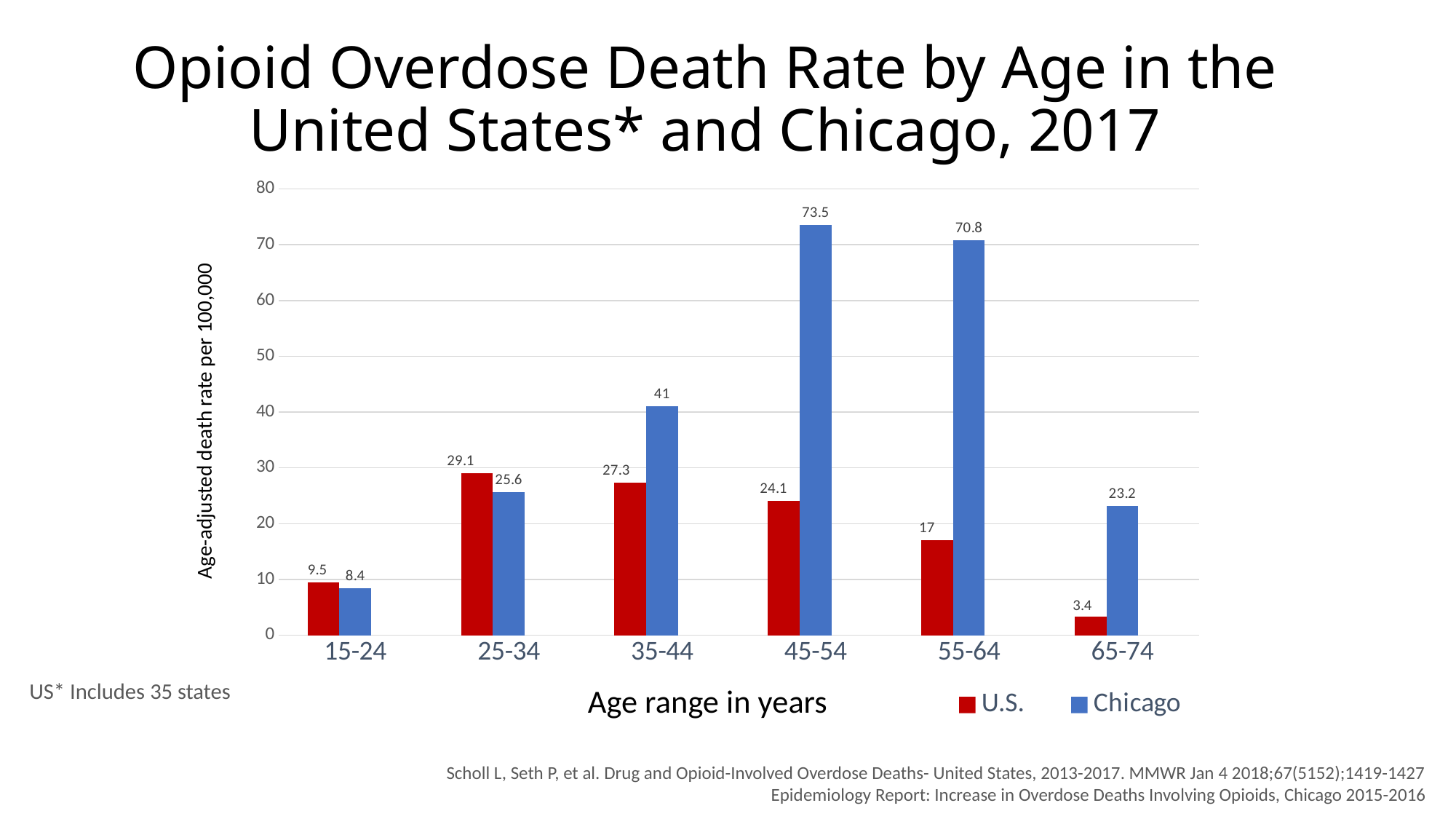
Is the Chicago value for the 35-44 age range greater or less than 30? greater Which age range has the lowest U.S. death rate? 65-74 What kind of chart is shown on the slide? Bar chart What is the difference between the Chicago and U.S. death rates for the 55-64 age range? 53.8 What is the Chicago opioid overdose death rate for the 45-54 age range? 73.5 What is the U.S. value for the 65-74 age range? 3.4 What is the U.S. opioid overdose death rate for the 25-34 age range? 29.1 How many age ranges are shown on the x axis? 6 Which age range has the highest Chicago death rate? 45-54 How many series does the legend list? 2 For the 25-34 age range, which is larger, the U.S. rate or the Chicago rate? U.S. What is the label of the y axis? Age-adjusted death rate per 100,000